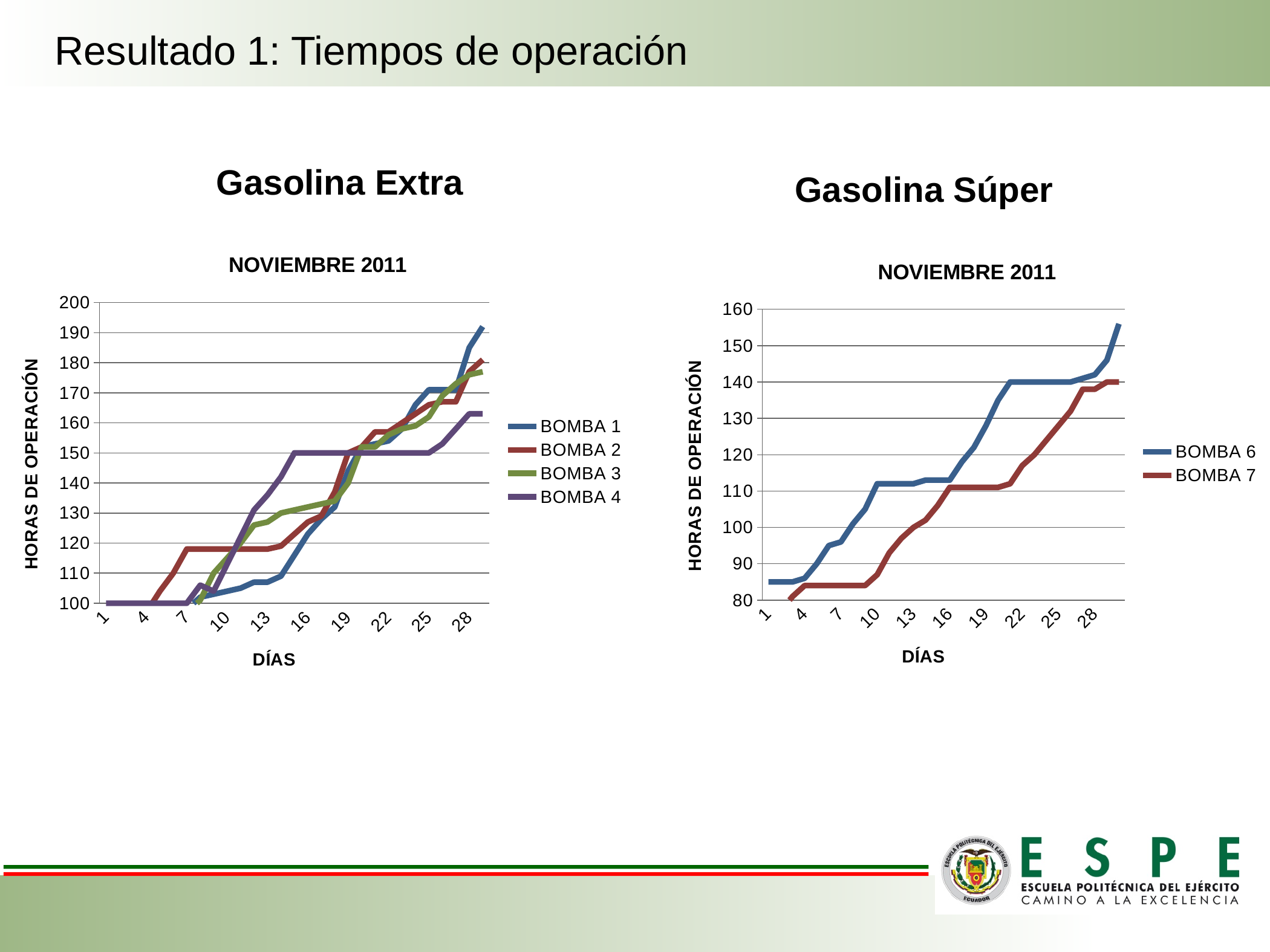
In the Gasolina Extra chart, which series has the lowest value at the last day shown? BOMBA 4 In the Gasolina Extra chart, which series has the highest value at the last day shown? BOMBA 1 In the Gasolina Extra chart, is the final value for BOMBA 1 greater or less than 180? greater In the Gasolina Súper chart, do the values for BOMBA 7 rise or fall along the x axis? rise In the Gasolina Súper chart, is the final value for BOMBA 6 greater or less than 150? greater In the Gasolina Súper chart, which series is larger at the last day shown, BOMBA 6 or BOMBA 7? BOMBA 6 What is the label of the y axis on the Gasolina Súper chart? HORAS DE OPERACIÓN In the Gasolina Extra chart, is the final value for BOMBA 4 greater or less than 170? less What kind of chart is the Gasolina Extra chart? line chart How many series does the legend of the Gasolina Extra chart list? 4 What subtitle appears above the plot area of the Gasolina Extra chart? NOVIEMBRE 2011 How many series does the legend of the Gasolina Súper chart list? 2